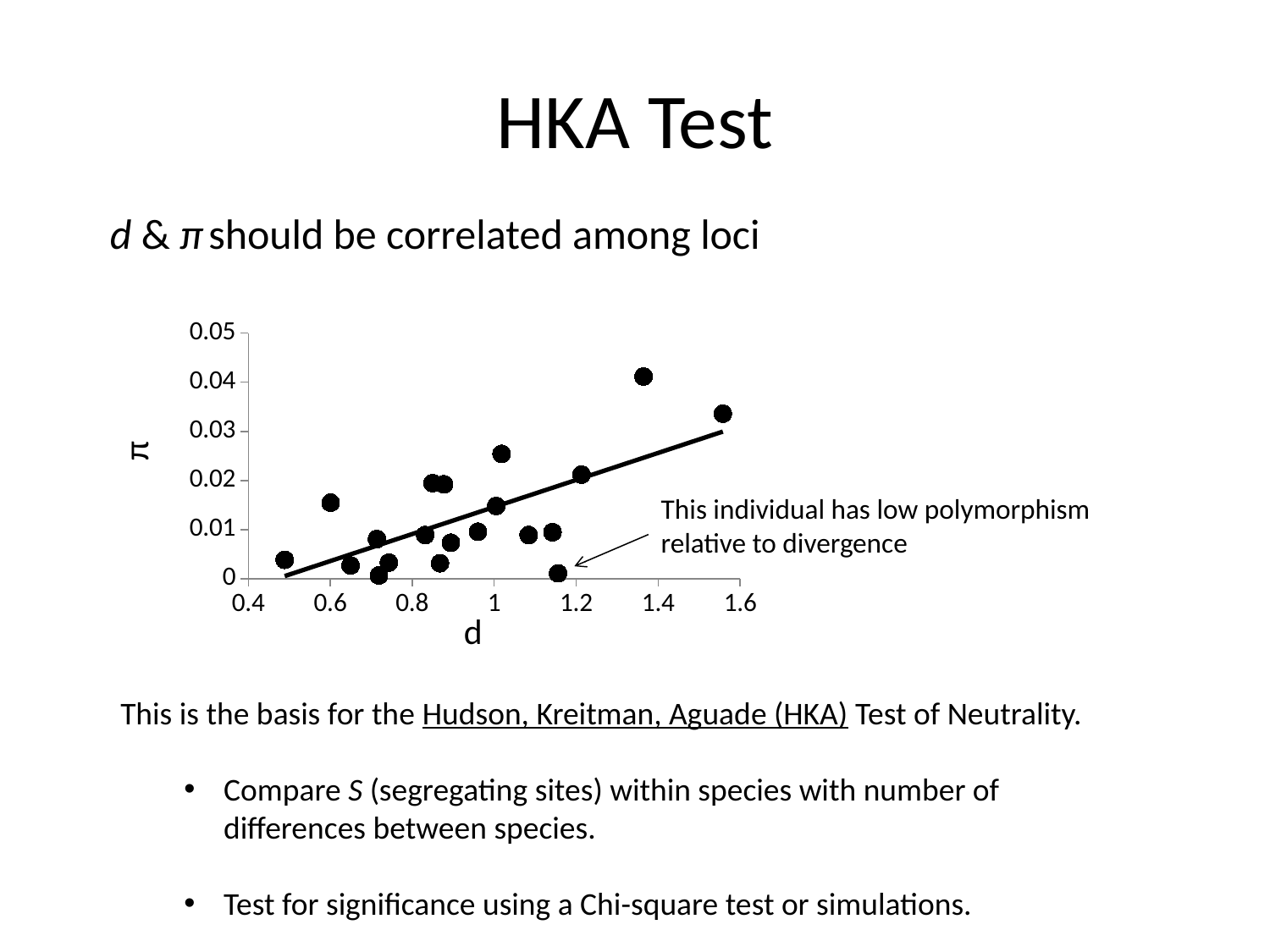
Is the π value of the point at d ≈ 1.56 greater or less than 0.03? greater Does the fitted line in the chart rise or fall as d increases? Rises Is the π value of the point at d ≈ 1.36 greater or less than 0.03? greater What is the label of the x axis of the chart? d What is the highest value shown on the y axis of the chart? 0.05 What is the highest value shown on the x axis of the chart? 1.6 Is the π value of the point indicated by the arrow (the individual with low polymorphism) greater or less than 0.01? less What kind of chart is shown on the slide? Scatter plot Which point has the highest π value: the one at d ≈ 1.36 or the one at d ≈ 1.56? The one at d ≈ 1.36